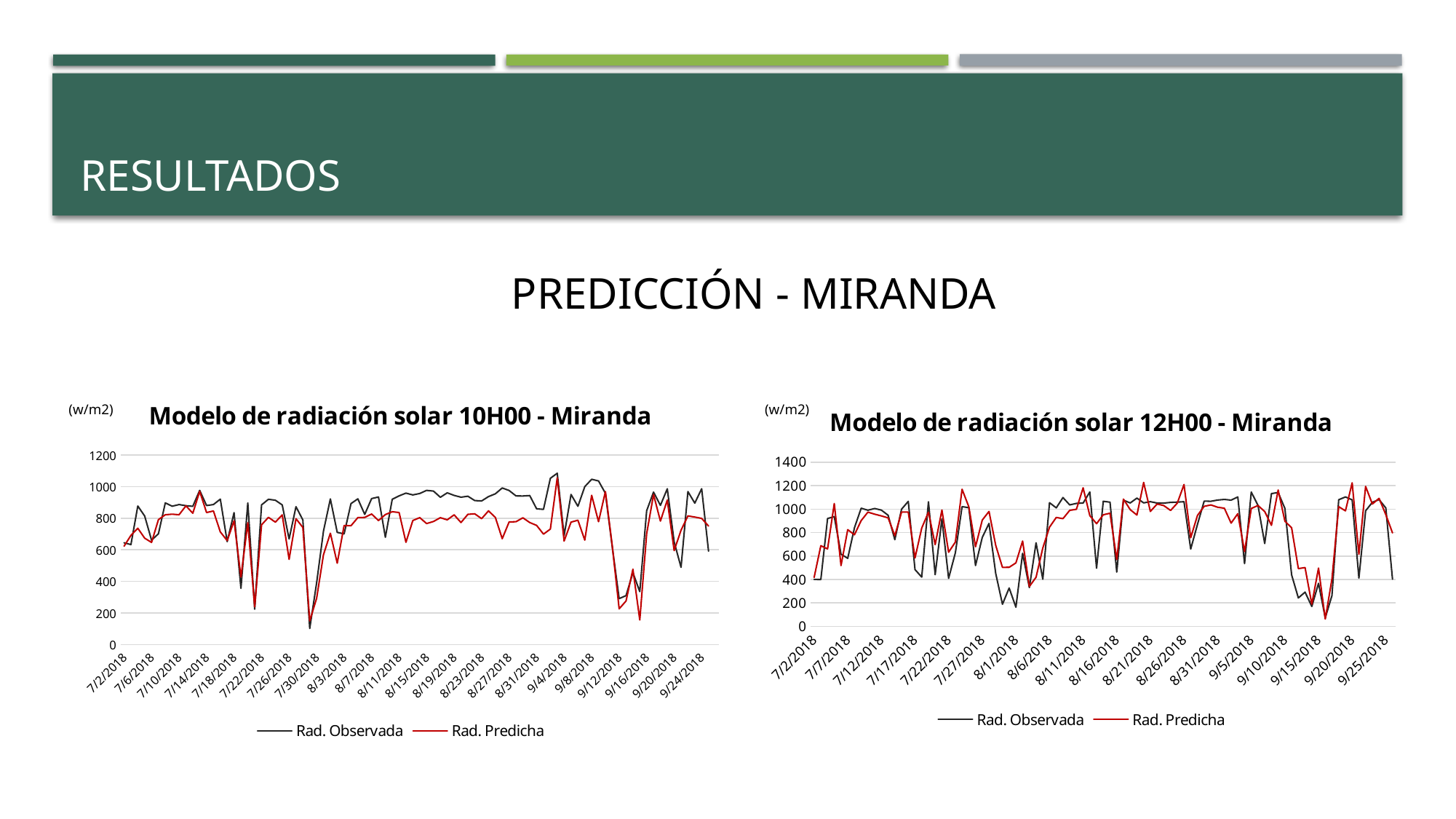
What is the highest value shown on the y axis of the 'Modelo de radiación solar 12H00 - Miranda' chart? 1400 In the 'Modelo de radiación solar 10H00 - Miranda' chart, is the Rad. Observada value at 8/27/2018 greater or less than 800? greater In the 'Modelo de radiación solar 10H00 - Miranda' chart, what colour is the Rad. Predicha line? Red In the 'Modelo de radiación solar 10H00 - Miranda' chart, is the Rad. Observada value at its lowest dip near 7/30/2018 greater or less than 400? less What kind of chart is the 'Modelo de radiación solar 10H00 - Miranda' chart? Line chart In the 'Modelo de radiación solar 12H00 - Miranda' chart, is the Rad. Predicha peak near 8/21/2018 greater or less than 1000? greater What is the first date shown on the x axis of the 'Modelo de radiación solar 10H00 - Miranda' chart? 7/2/2018 What are the two series named in the legend of the 'Modelo de radiación solar 12H00 - Miranda' chart? Rad. Observada and Rad. Predicha How many series does the legend of the 'Modelo de radiación solar 12H00 - Miranda' chart list? 2